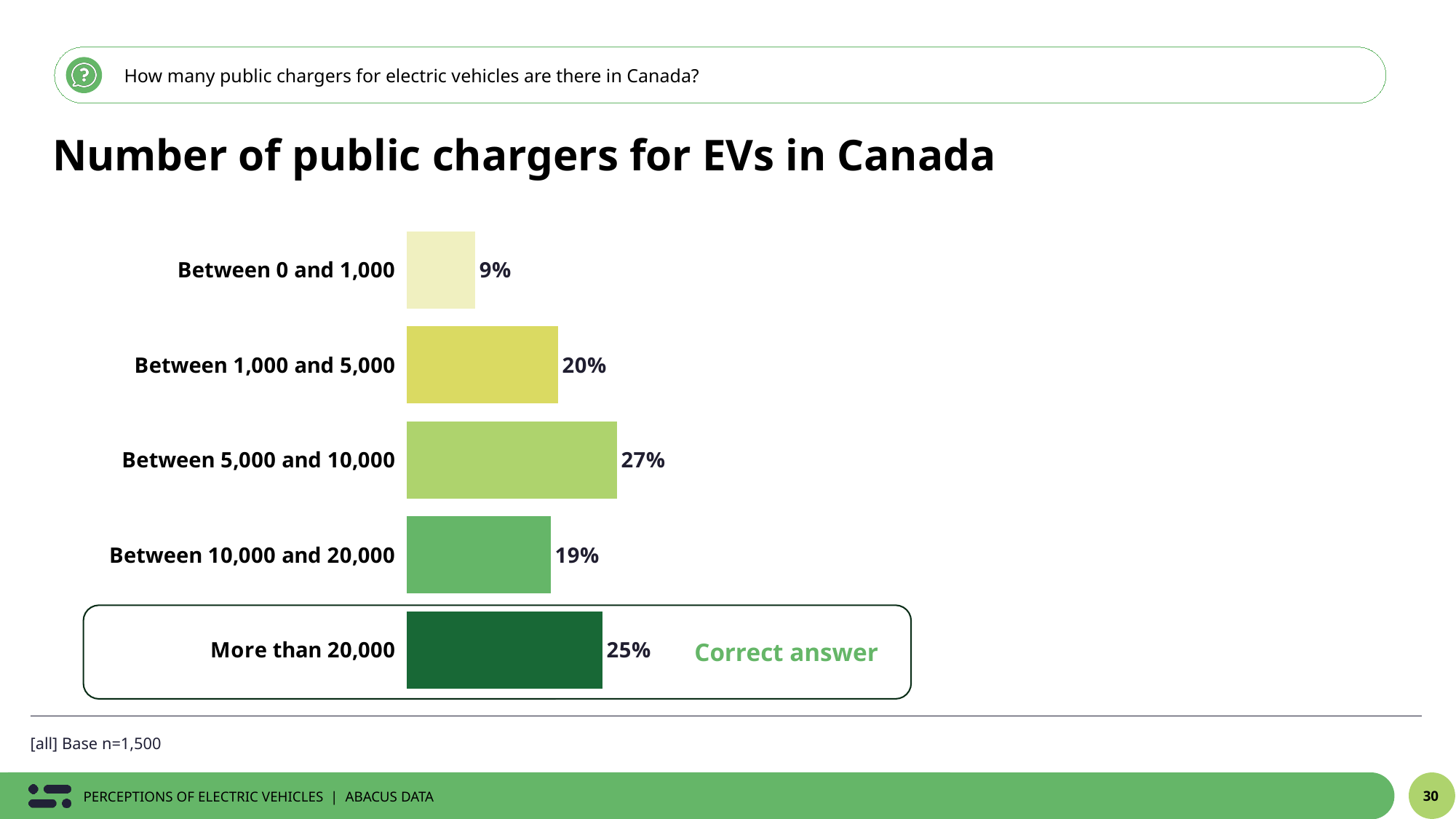
What type of chart is shown on the slide? Bar chart What percentage of respondents answered "Between 0 and 1,000"? 9% What percentage of respondents answered "Between 10,000 and 20,000"? 19% Which is larger: the percentage for "Between 1,000 and 5,000" or for "More than 20,000"? More than 20,000 Which response category has the highest percentage? Between 5,000 and 10,000 What percentage of respondents answered "More than 20,000"? 25% Which response category has the lowest percentage? Between 0 and 1,000 What is the difference in percentage points between "More than 20,000" and "Between 10,000 and 20,000"? 6 What is the difference in percentage points between "Between 5,000 and 10,000" and "Between 0 and 1,000"? 18 How many response categories are shown in the chart? 5 What percentage of respondents answered "Between 5,000 and 10,000"? 27% Which response category is marked as the correct answer? More than 20,000